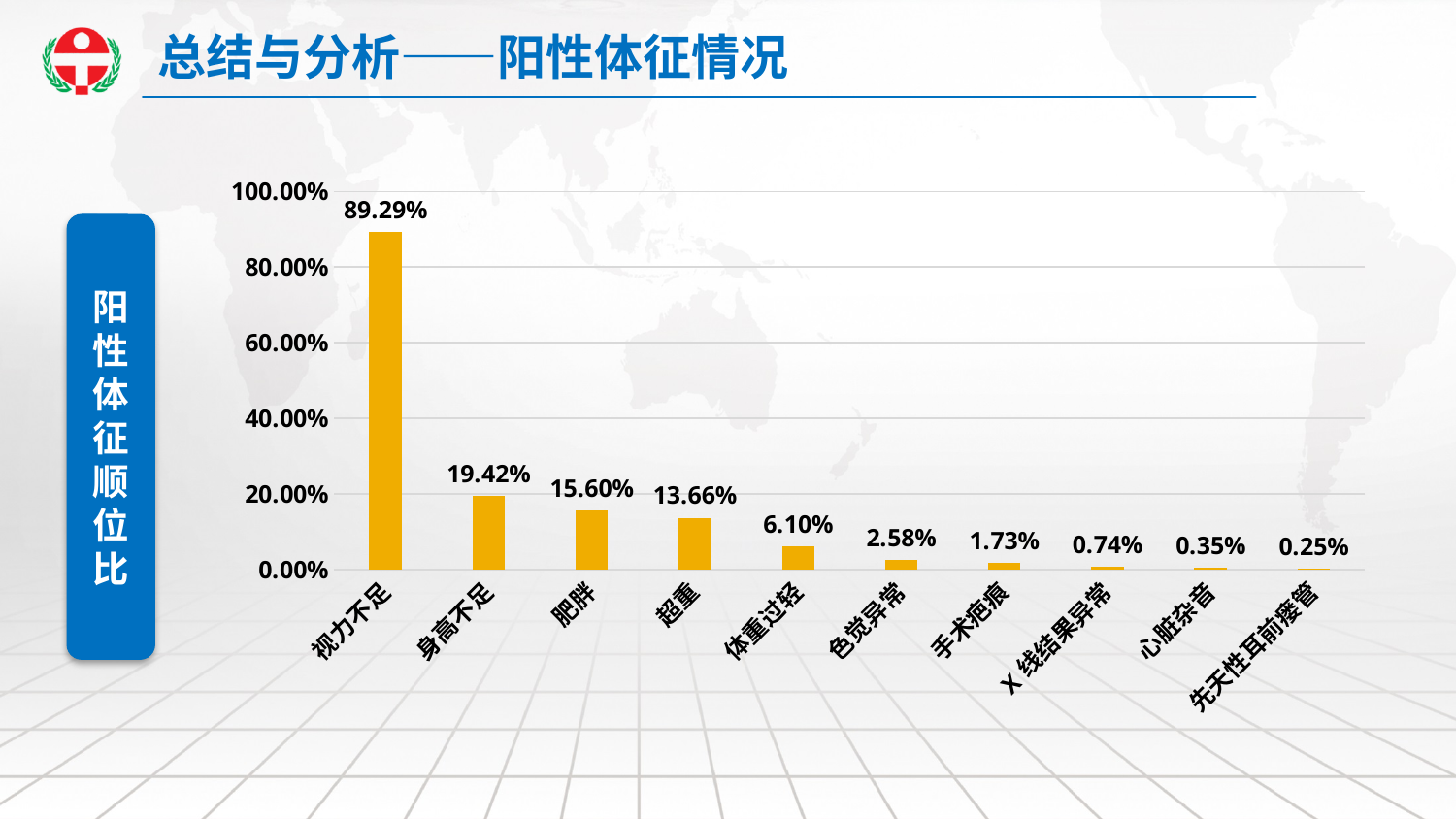
What is the value for 肥胖? 15.60% Which category has the lowest value? 先天性耳前瘘管 What is the value for 先天性耳前瘘管? 0.25% What is the difference between the values for 身高不足 and 肥胖? 3.82% Which is larger, the value for 超重 or the value for 体重过轻? 超重 How many categories are shown on the x axis? 10 What is the value for 体重过轻? 6.10% What kind of chart is shown on the slide? Bar chart What is the value for 视力不足? 89.29% Which category has the highest value? 视力不足 What is the value for 身高不足? 19.42% Do the values rise or fall from left to right along the x axis? Fall